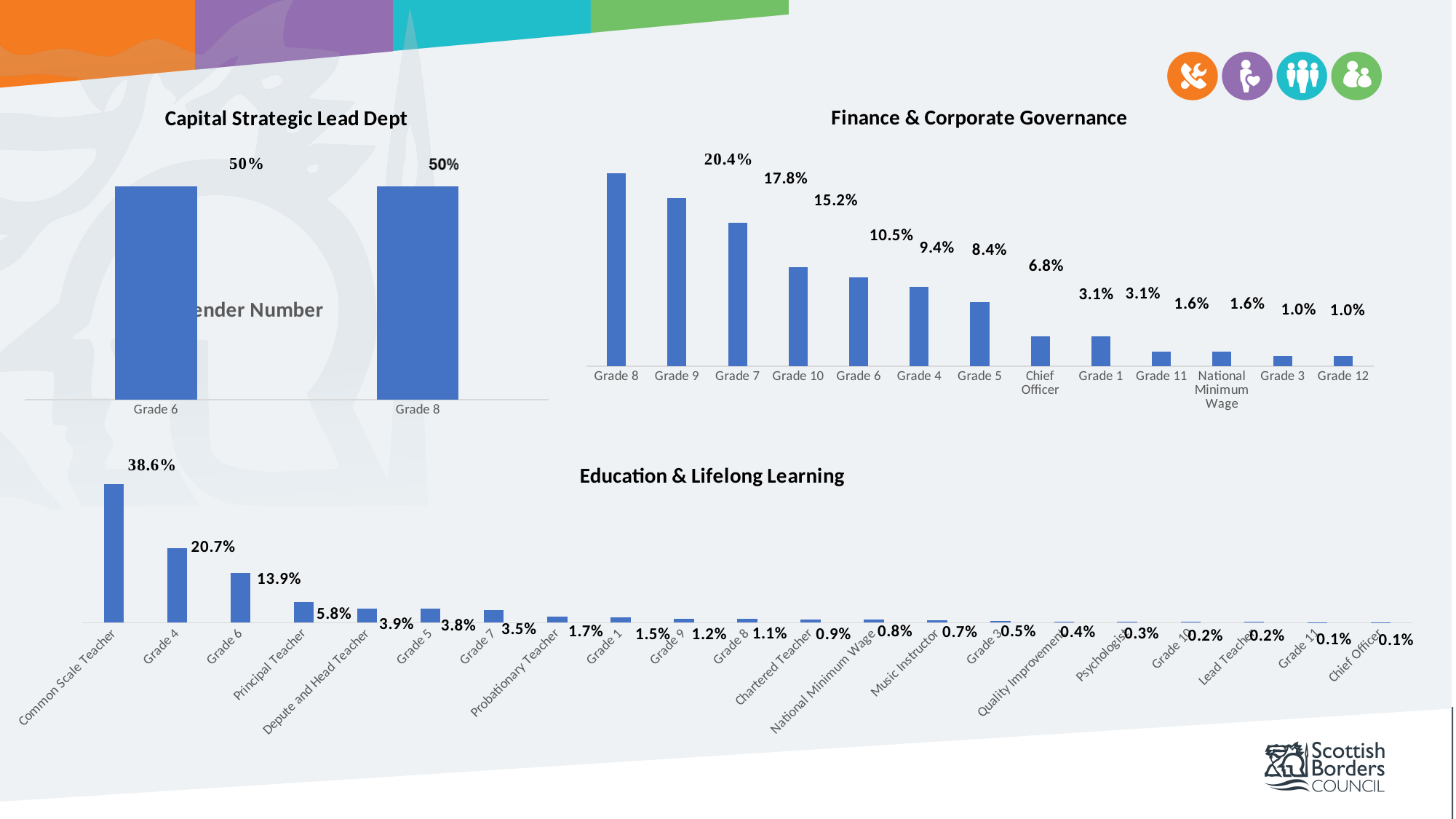
In the Finance & Corporate Governance chart, what is the value for Chief Officer? 3.1% What kind of chart is the Capital Strategic Lead Dept chart? Bar chart In the Education & Lifelong Learning chart, what is the value for Probationary Teacher? 1.7% In the Finance & Corporate Governance chart, do the values rise or fall from left to right? Fall In the Education & Lifelong Learning chart, what is the difference between Grade 4 and Grade 6? 6.8% In the Education & Lifelong Learning chart, what is the value for Common Scale Teacher? 38.6% In the Capital Strategic Lead Dept chart, what is the value for Grade 6? 50% In the Finance & Corporate Governance chart, how many categories are shown? 13 In the Finance & Corporate Governance chart, what is the difference between Grade 8 and Grade 7? 5.2% In the Finance & Corporate Governance chart, what is the value for Grade 9? 17.8% In the Education & Lifelong Learning chart, which is larger, Principal Teacher or Depute and Head Teacher? Principal Teacher In the Finance & Corporate Governance chart, which category has the highest value? Grade 8